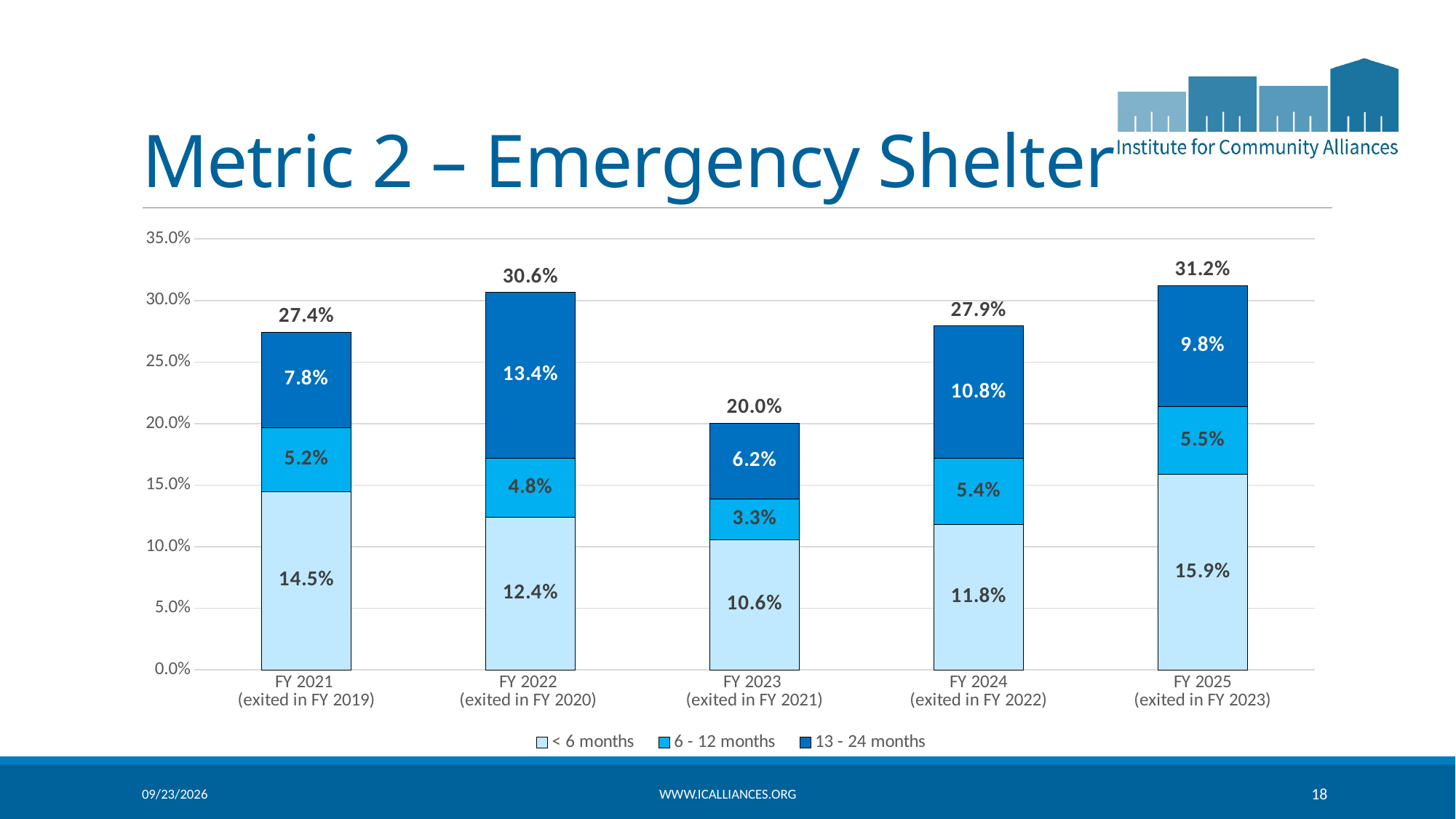
How many fiscal years are shown on the x axis? 5 What is the value of the '6 - 12 months' segment for FY 2025? 5.5% What is the title of the slide? Metric 2 – Emergency Shelter What is the total for the FY 2023 bar? 20.0% Which is larger, the '< 6 months' value for FY 2024 or for FY 2022? FY 2022 How many series does the legend list? 3 Which fiscal year has the highest total? FY 2025 What is the value of the '13 - 24 months' segment for FY 2022? 13.4% What is the value of the '< 6 months' segment for FY 2021? 14.5% What is the difference between the totals for FY 2025 and FY 2023? 11.2% What kind of chart is shown on the slide? Stacked bar chart Which fiscal year has the lowest total? FY 2023